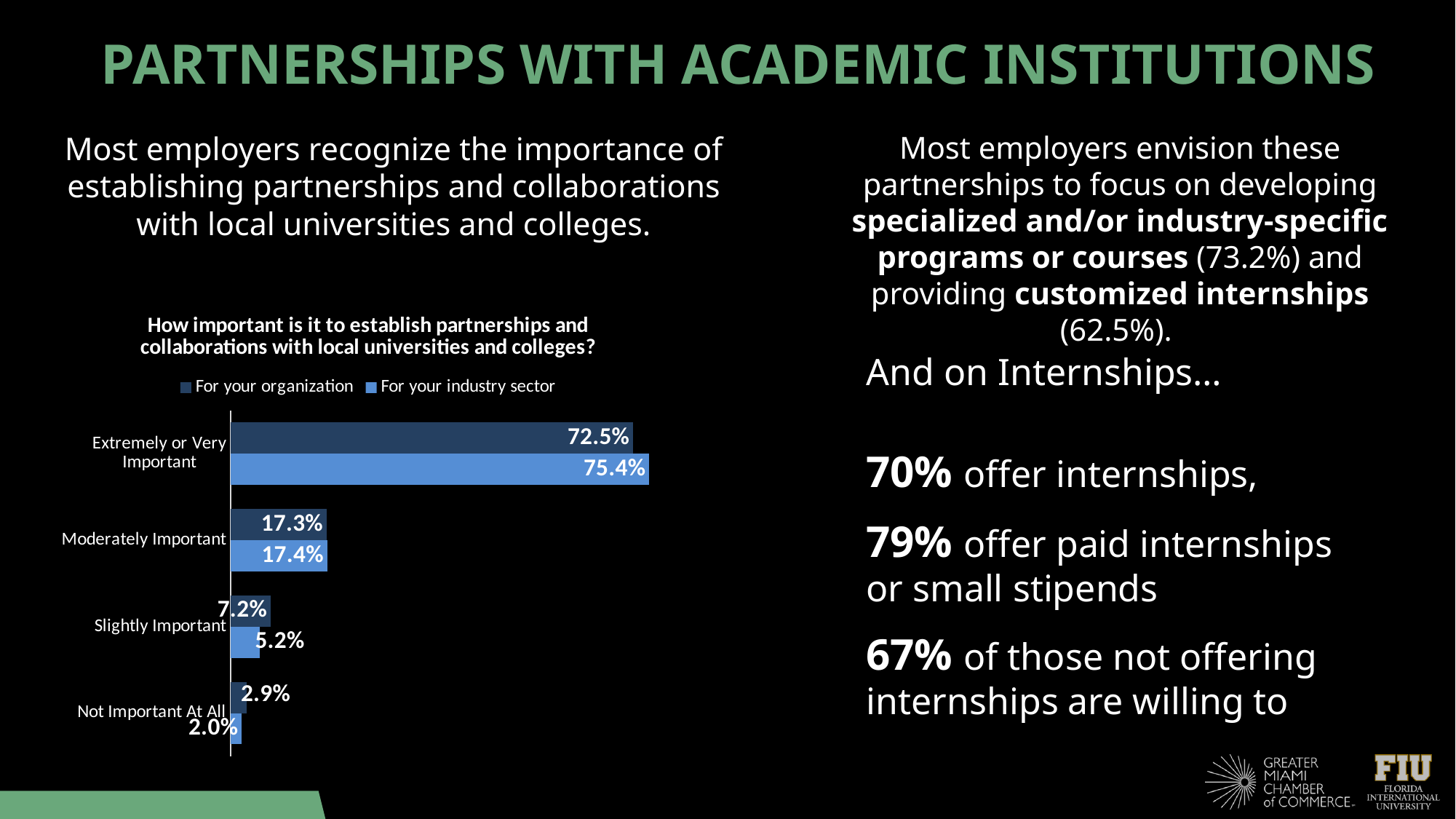
How many categories are shown on the chart? 4 What is the value for 'Slightly Important' in the 'For your organization' series? 7.2% Which category has the lowest value in the 'For your industry sector' series? Not Important At All How many series does the chart legend list? 2 What is the difference between the 'For your industry sector' and 'For your organization' values for 'Extremely or Very Important'? 2.9% For 'Slightly Important', which series has the larger value: 'For your organization' or 'For your industry sector'? For your organization What is the title of the chart? How important is it to establish partnerships and collaborations with local universities and colleges? What is the value for 'Extremely or Very Important' in the 'For your industry sector' series? 75.4% What is the value for 'Moderately Important' in the 'For your organization' series? 17.3% What kind of chart is shown on the slide? Bar chart Which category has the highest value in the 'For your organization' series? Extremely or Very Important What is the value for 'Not Important At All' in the 'For your industry sector' series? 2.0%